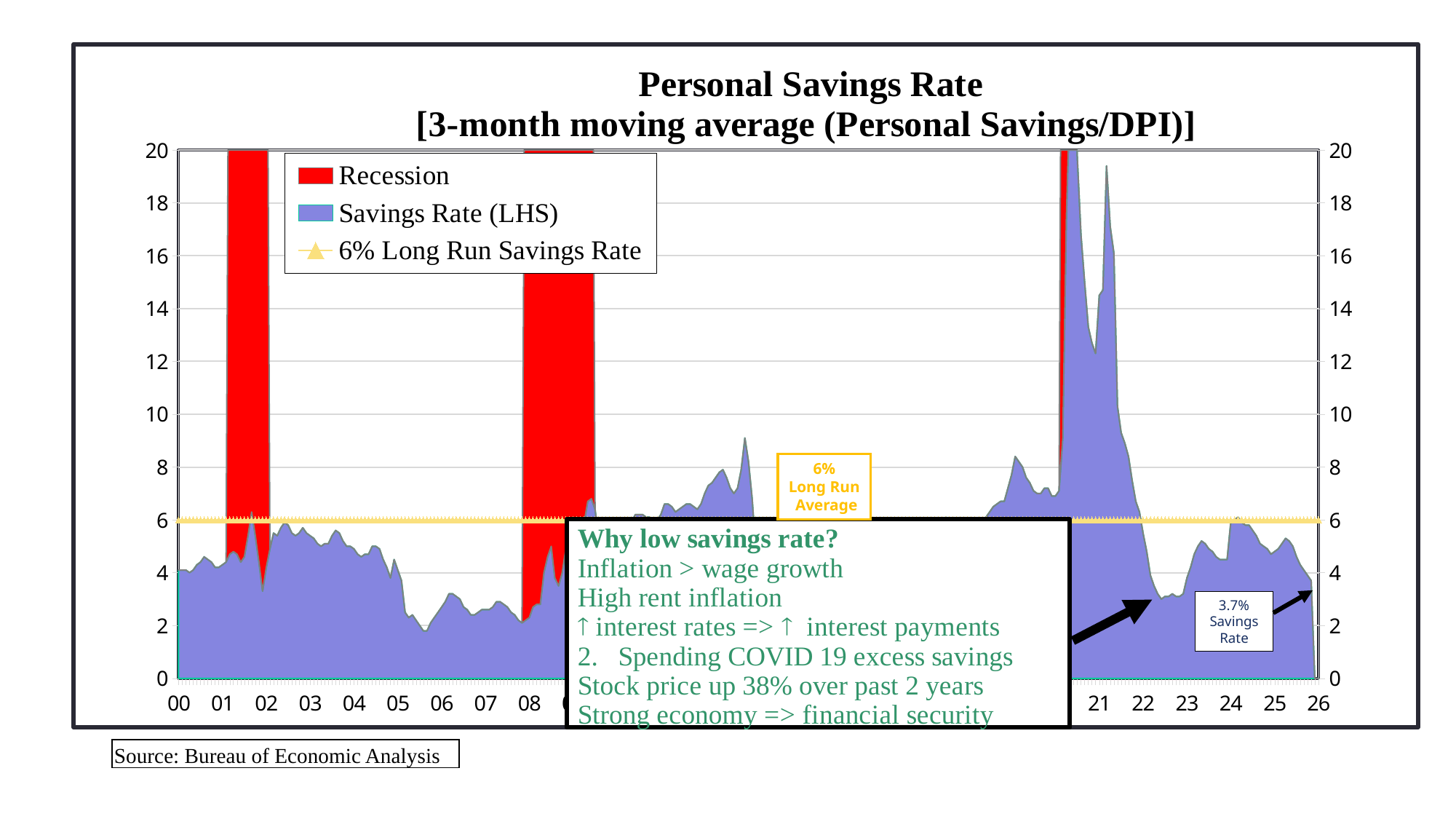
Is the savings rate in 2023 greater or less than 6? less Is the savings rate in 2005 greater or less than 4? less Is the peak savings rate in 2020 greater or less than 16? greater What kind of chart is shown on the slide? area chart What is the title of the chart? Personal Savings Rate [3-month moving average (Personal Savings/DPI)] Which is larger, the peak savings rate in 2020 or the peak savings rate in 2008? 2020 How many series does the legend list? 3 What is the long run savings rate shown by the horizontal line? 6% What is the most recent savings rate value annotated on the chart? 3.7% Does the savings rate rise or fall from 2021 to 2022? fall What is the maximum value shown on the y axis? 20